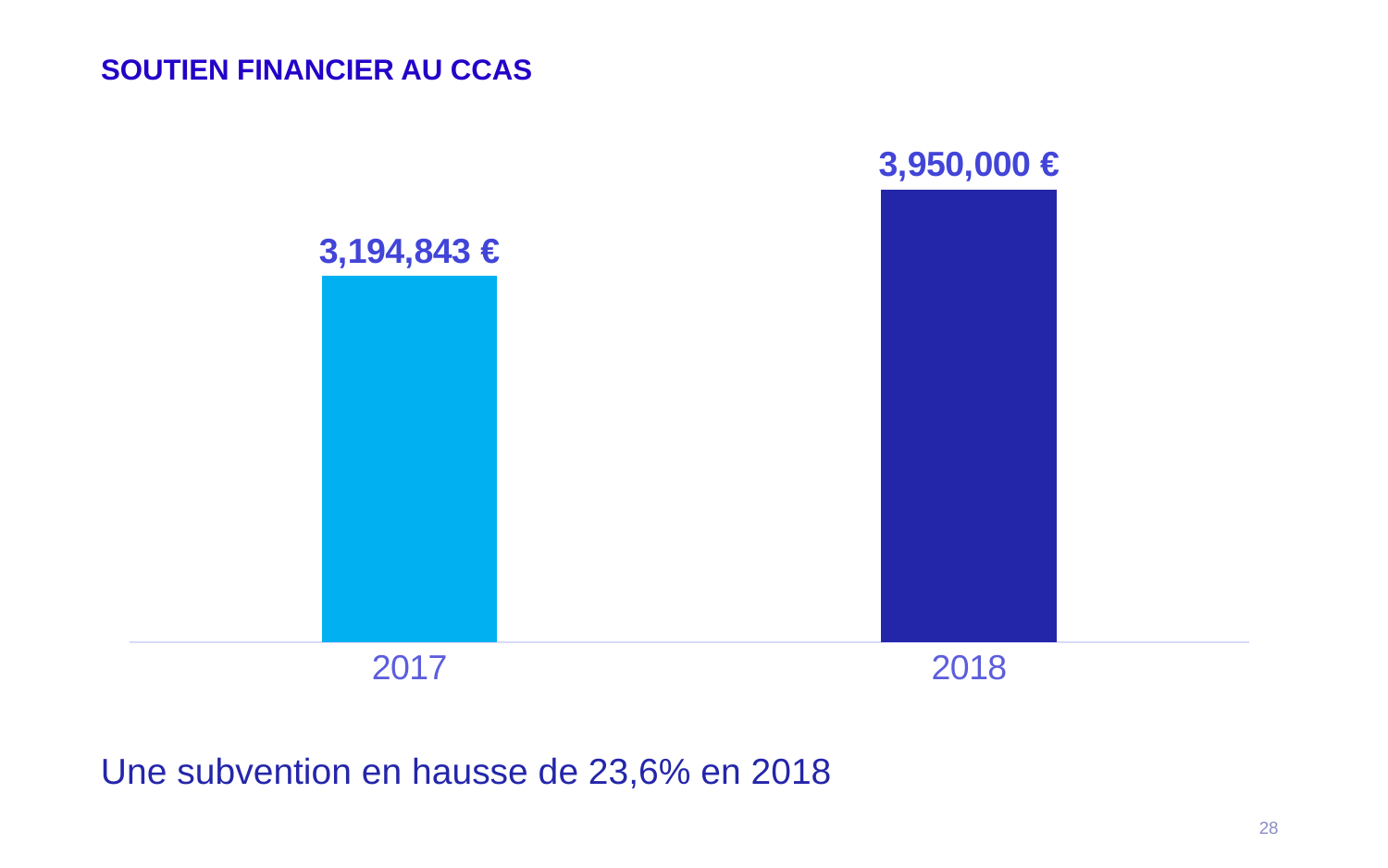
Which year has the lowest value? 2017 Do the values rise or fall from 2017 to 2018? Rise According to the text below the chart, by what percentage did the subsidy increase in 2018? 23,6% What is the value shown for 2017? 3,194,843 € What is the difference between the 2018 and 2017 values? 755,157 € What is the value shown for 2018? 3,950,000 € Which year has the highest value? 2018 What kind of chart is shown on the slide? Bar chart How many bars are shown in the chart? 2 Which is larger, the value for 2017 or the value for 2018? 2018 What is the title of the slide containing the chart? SOUTIEN FINANCIER AU CCAS